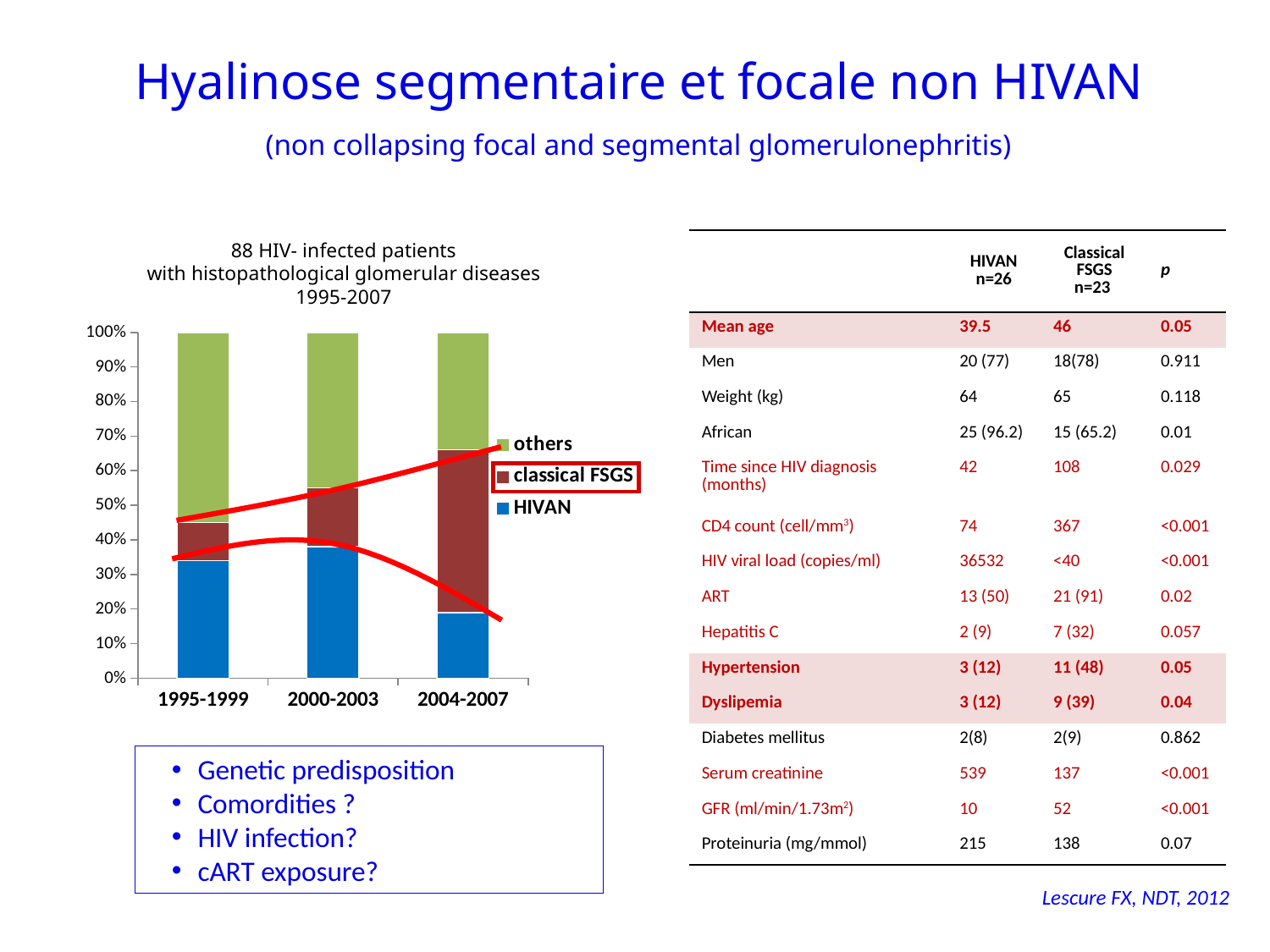
Which period has the largest classical FSGS share? 2004-2007 Does the classical FSGS share rise or fall across the periods from 1995-1999 to 2004-2007? rise Which period has the smallest HIVAN share? 2004-2007 How many time periods are shown on the x axis of the chart? 3 Is the HIVAN share for 1995-1999 greater or less than 40%? less How many series does the chart legend list? 3 What is the title of the chart? 88 HIV- infected patients with histopathological glomerular diseases 1995-2007 Which series are listed in the chart legend? others, classical FSGS, HIVAN Is the 'others' share for 1995-1999 greater or less than 50%? greater Is the classical FSGS share for 2004-2007 greater or less than 40%? greater What kind of chart is shown on the left of the slide? Stacked bar chart